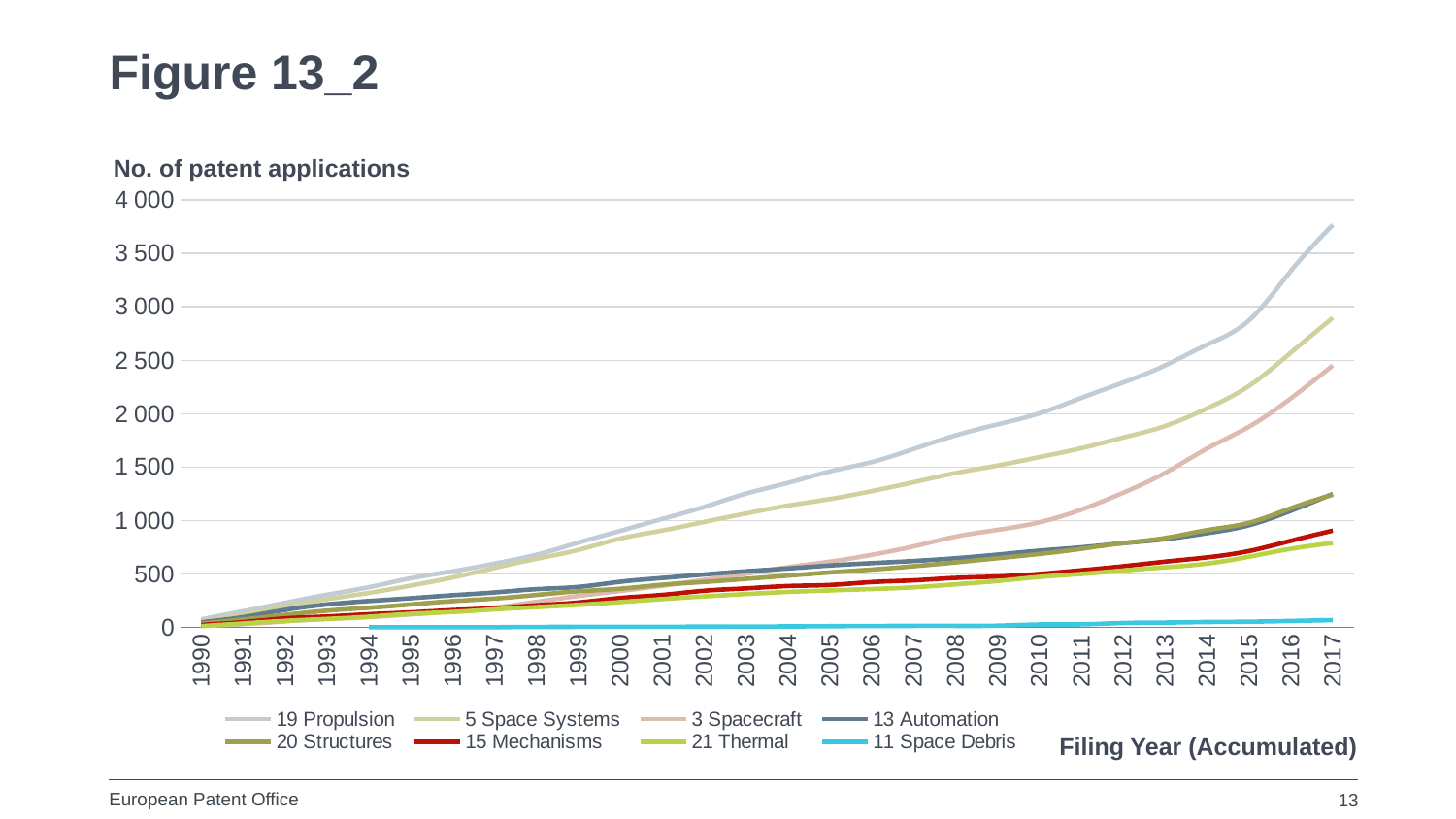
How many series does the legend list? 8 Is the value for 21 Thermal in 2017 greater or less than 1 000? less How many filing years are shown on the x axis? 28 Is the value for 19 Propulsion in 2017 greater or less than 3 500? greater Is the value for 3 Spacecraft in 2017 greater or less than 2 000? greater Which is larger in 2017, 5 Space Systems or 3 Spacecraft? 5 Space Systems What kind of chart is shown on the slide? line chart Which series has the highest value in 2017? 19 Propulsion Does the 19 Propulsion line rise or fall from 1990 to 2017? rise Which series has the lowest value in 2017? 11 Space Debris What is the title of the x axis? Filing Year (Accumulated)